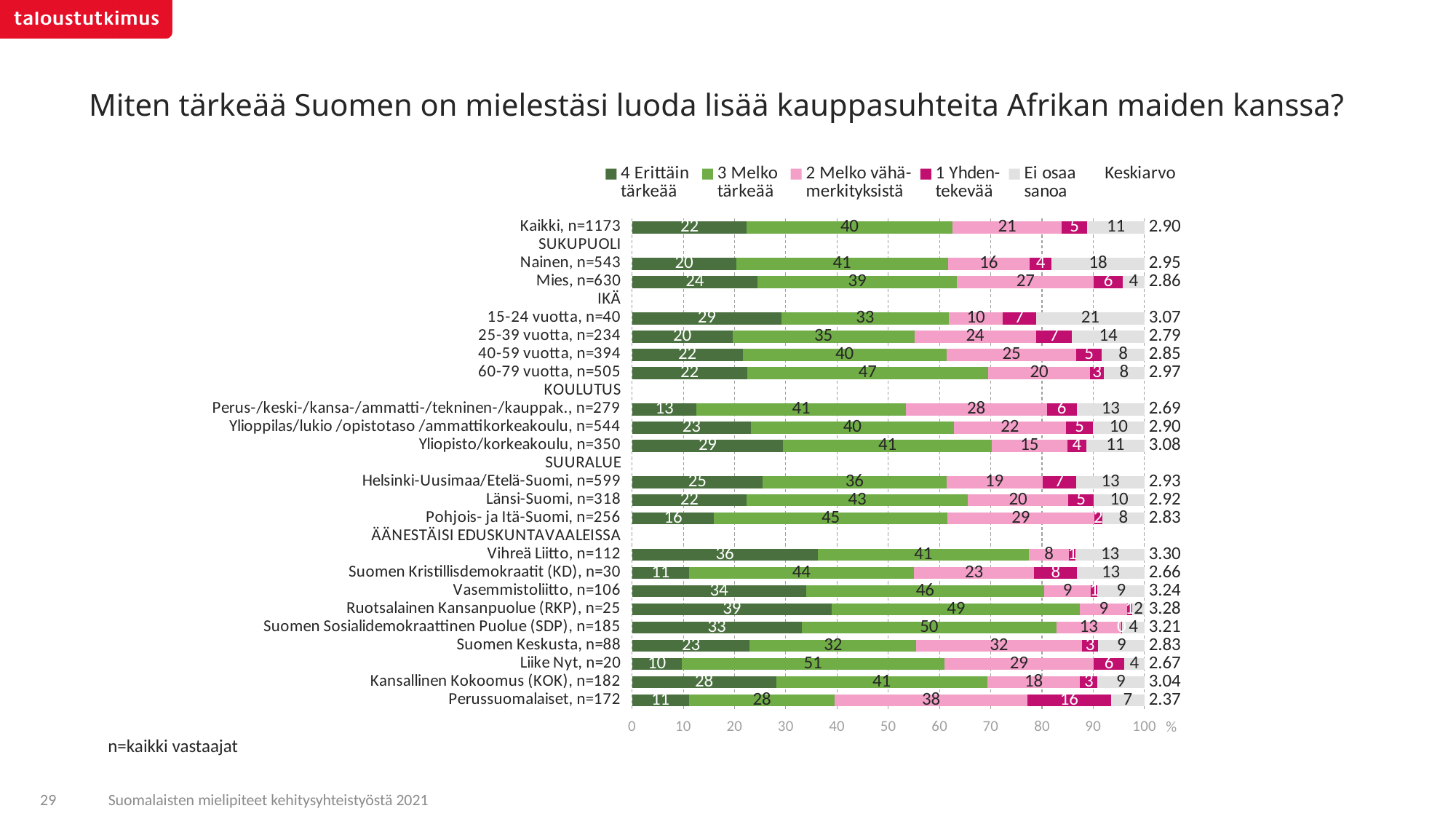
What percentage of all respondents (Kaikki, n=1173) answered '4 Erittäin tärkeää'? 22 What type of chart is shown on the slide? Stacked bar chart What is the difference in the '4 Erittäin tärkeää' share between Mies, n=630 and Nainen, n=543? 4 What is the title of the chart? Miten tärkeää Suomen on mielestäsi luoda lisää kauppasuhteita Afrikan maiden kanssa? Which group has the lowest Keskiarvo value? Perussuomalaiset, n=172 Which group has the highest Keskiarvo value? Vihreä Liitto, n=112 What percentage of Perussuomalaiset, n=172 answered '1 Yhdentekevää'? 16 What is the Keskiarvo (average) for Vihreä Liitto, n=112? 3.30 What percentage of Liike Nyt, n=20 answered '3 Melko tärkeää'? 51 Which has a larger 'Ei osaa sanoa' share, Nainen, n=543 or Mies, n=630? Nainen, n=543 How many party groups are listed under ÄÄNESTÄISI EDUSKUNTAVAALEISSA? 9 Which group has the highest share of '4 Erittäin tärkeää' answers? Ruotsalainen Kansanpuolue (RKP), n=25